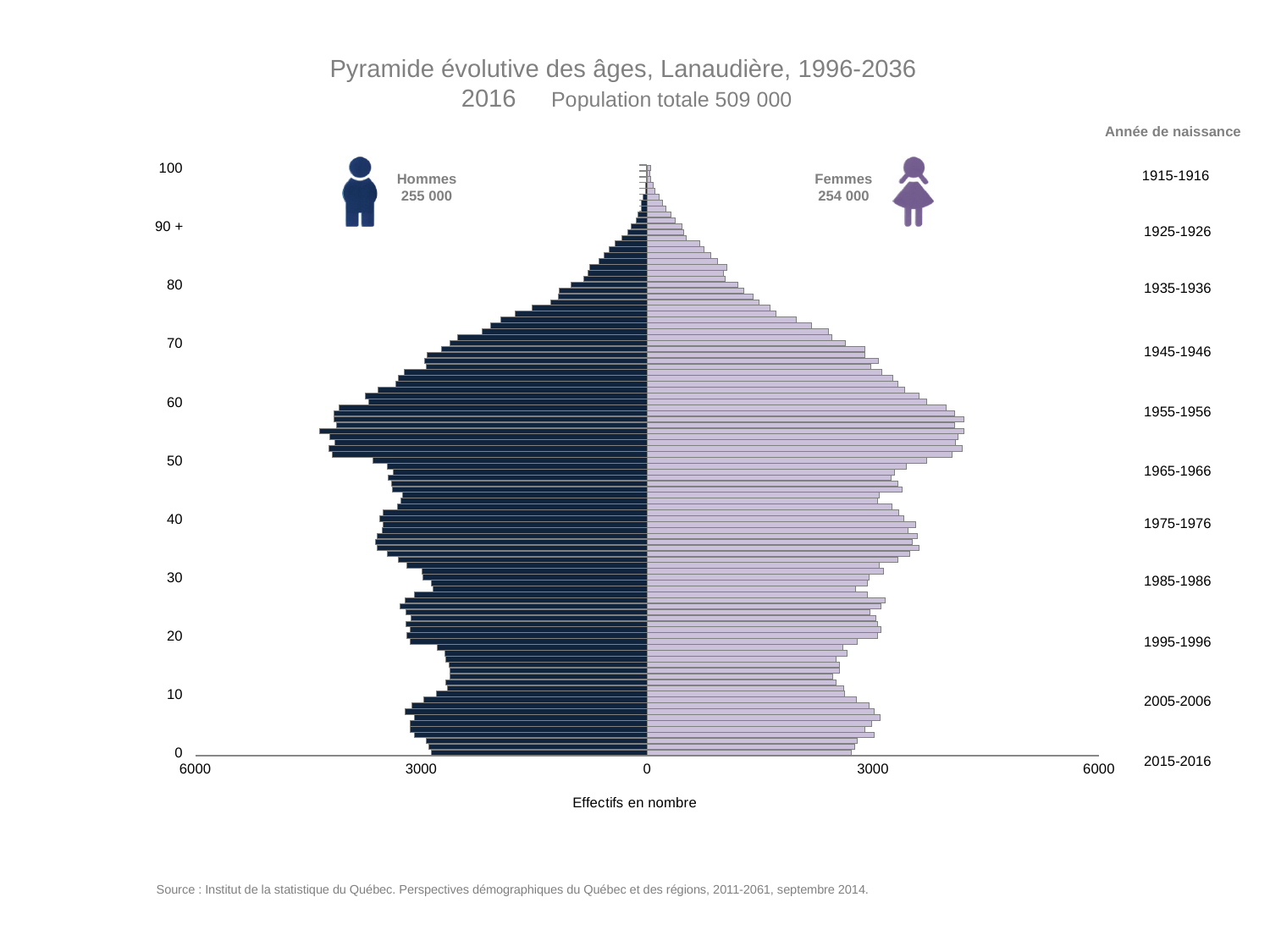
What birth years (Année de naissance) correspond to age 0 on the chart? 2015-2016 What total population is shown for 2016? 509 000 What kind of chart is this? Bar chart (population pyramid) Is the value for Femmes at age 75 greater or less than 3000? less What is the difference between the Hommes total and the Femmes total? 1 000 What is the number of Femmes shown on the chart? 254 000 What is the title of the chart? Pyramide évolutive des âges, Lanaudière, 1996-2036 Is the value for Hommes at age 85 greater or less than 3000? less What is the number of Hommes shown on the chart? 255 000 Which group is larger, Hommes or Femmes? Hommes Is the value for Hommes at age 55 greater or less than 3000? greater Do the values rise or fall as age increases from 60 to 100? fall